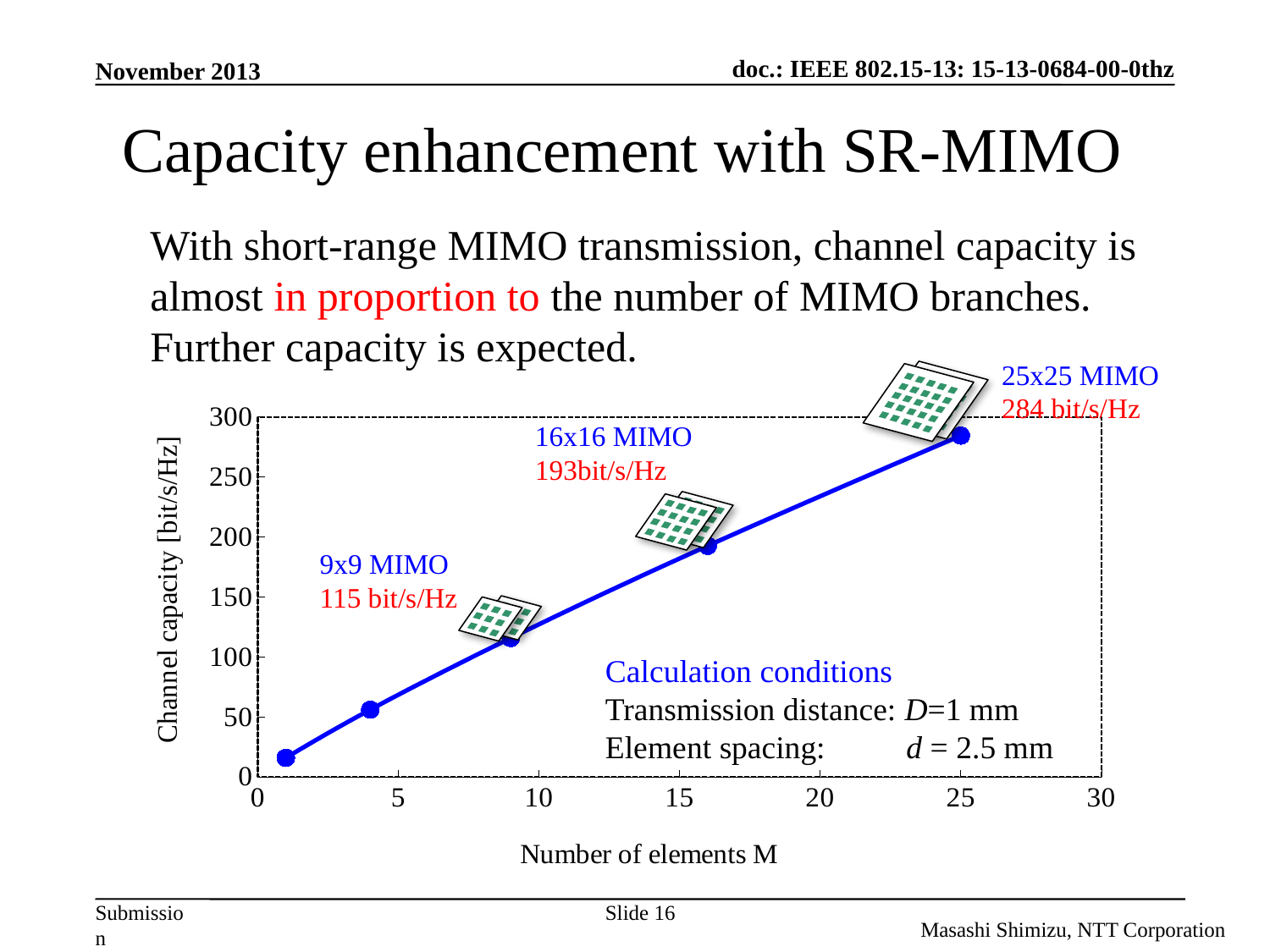
What is the difference in channel capacity between the 25x25 MIMO and 16x16 MIMO points? 91 bit/s/Hz Which has the larger channel capacity, 16x16 MIMO or 9x9 MIMO? 16x16 MIMO Which labelled configuration has the highest channel capacity? 25x25 MIMO Does channel capacity rise or fall as the number of elements M increases? rise What is the difference in channel capacity between the 16x16 MIMO and 9x9 MIMO points? 78 bit/s/Hz How many data points are plotted on the line? 5 What channel capacity is labelled for the 16x16 MIMO point? 193bit/s/Hz Is the channel capacity at M=4 greater or less than 100 bit/s/Hz? less What channel capacity is labelled for the 9x9 MIMO point? 115 bit/s/Hz What is the difference in channel capacity between the 25x25 MIMO and 9x9 MIMO points? 169 bit/s/Hz What kind of chart is shown on the slide? line chart What channel capacity is labelled for the 25x25 MIMO point? 284 bit/s/Hz